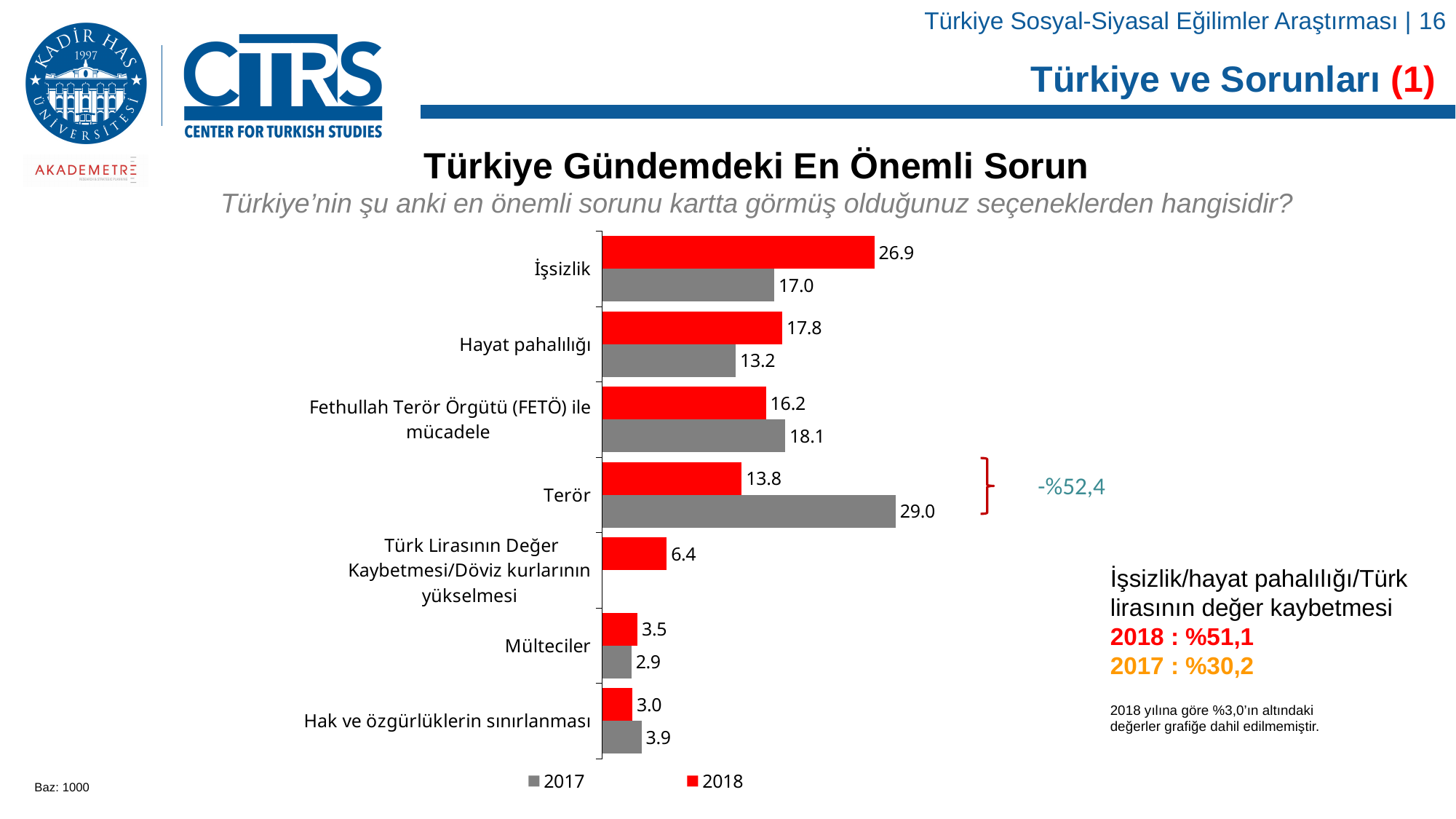
How many series does the legend list? 2 What kind of chart is shown on the slide? Bar chart Which category has the highest 2017 value? Terör What is the difference between the 2018 and 2017 values for İşsizlik? 9.9 What is the 2017 value for Terör? 29.0 Which is larger for Fethullah Terör Örgütü (FETÖ) ile mücadele, the 2017 value or the 2018 value? 2017 What is the 2018 value for İşsizlik? 26.9 How many categories are shown on the chart? 7 Which category has the highest 2018 value? İşsizlik What is the 2018 value for Mülteciler? 3.5 What is the 2017 value for Hayat pahalılığı? 13.2 Which category has the lowest 2018 value? Hak ve özgürlüklerin sınırlanması